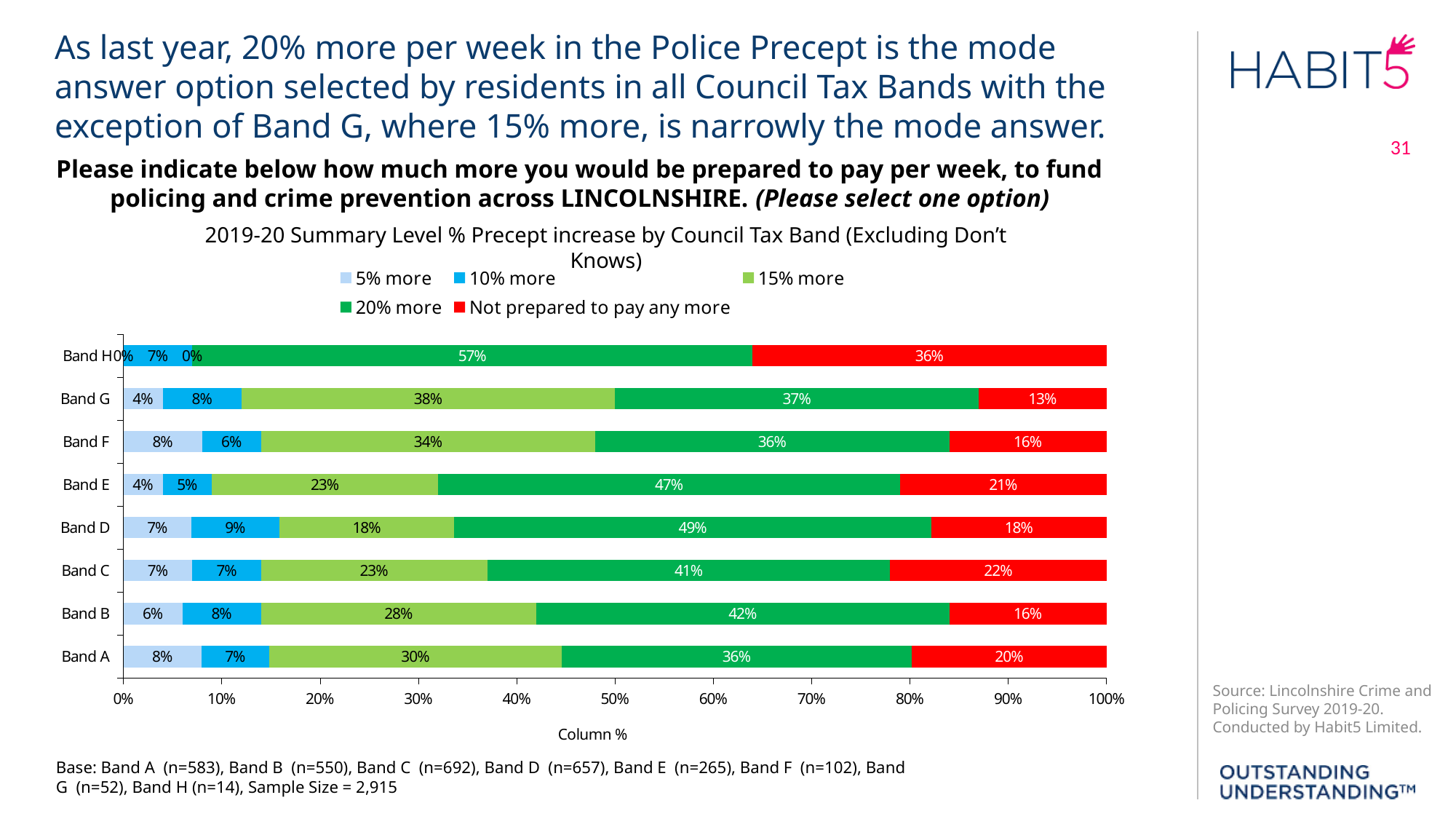
Which is larger for Band G: the '15% more' value or the '20% more' value? 15% more What percentage of Band H residents selected '20% more'? 57% How many Council Tax Bands are plotted on the chart? 8 What percentage of Band G residents selected '15% more'? 38% How many series does the legend list? 5 Which band has the highest value for '20% more'? Band H What percentage of Band D residents selected '10% more'? 9% What percentage of Band C residents were 'Not prepared to pay any more'? 22% What is the difference between the '20% more' values for Band D and Band A? 13% What is the label on the horizontal axis of the chart? Column % Which band has the lowest value for 'Not prepared to pay any more'? Band G What kind of chart is shown on the slide? Stacked bar chart